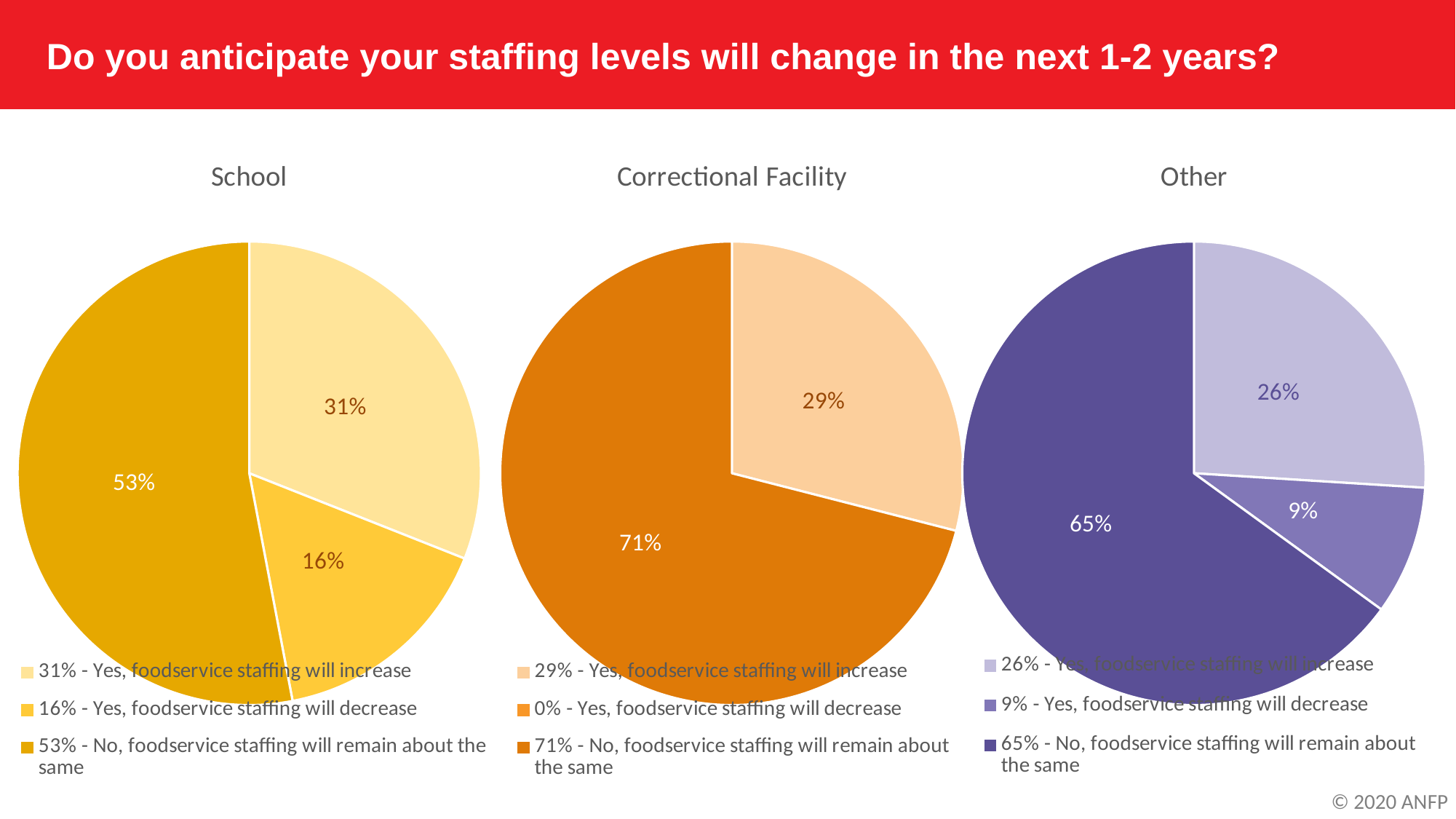
In the Other pie chart, which response has the smallest share? Yes, foodservice staffing will decrease In the School pie chart, what is the difference between the share saying staffing will increase and the share saying it will decrease? 15% What is the title of the chart on the right of the slide? Other In the Other pie chart, what share of respondents said foodservice staffing will decrease? 9% What type of chart is used for the School data? Pie chart In the School pie chart, which response has the largest share? No, foodservice staffing will remain about the same How many entries does the legend of the Correctional Facility chart list? 3 In the Correctional Facility pie chart, what share of respondents said foodservice staffing will decrease? 0% Which is larger: the share saying staffing will remain about the same in the Correctional Facility chart or in the Other chart? Correctional Facility How many pie charts are shown on the slide? 3 In the Correctional Facility pie chart, what share of respondents said foodservice staffing will increase? 29% In the School pie chart, what share of respondents said foodservice staffing will remain about the same? 53%